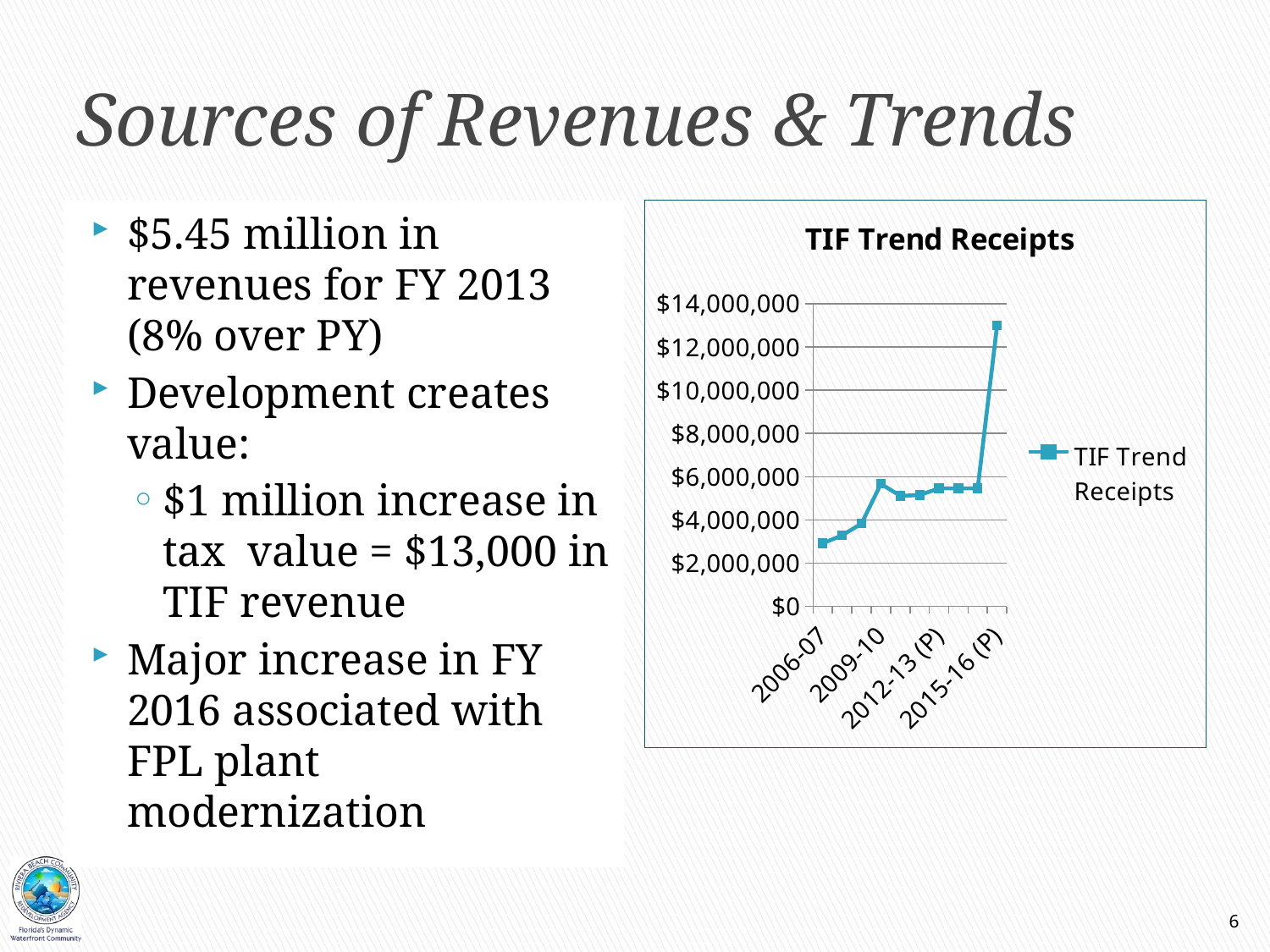
Which is larger, the value for 2015-16 (P) or the value for 2009-10? 2015-16 (P) How many series does the chart legend list? 1 Is the value for 2006-07 greater or less than $4,000,000? less Which year has the highest TIF Trend Receipts value? 2015-16 (P) Is the value for 2012-13 (P) greater or less than $8,000,000? less Is the value for 2015-16 (P) greater or less than $12,000,000? greater Do the TIF Trend Receipts values generally rise or fall from 2006-07 to 2015-16 (P)? Rise Which year has the lowest TIF Trend Receipts value? 2006-07 What is the title of the chart? TIF Trend Receipts What is the name of the series shown in the chart legend? TIF Trend Receipts What kind of chart is shown on the slide? Line chart